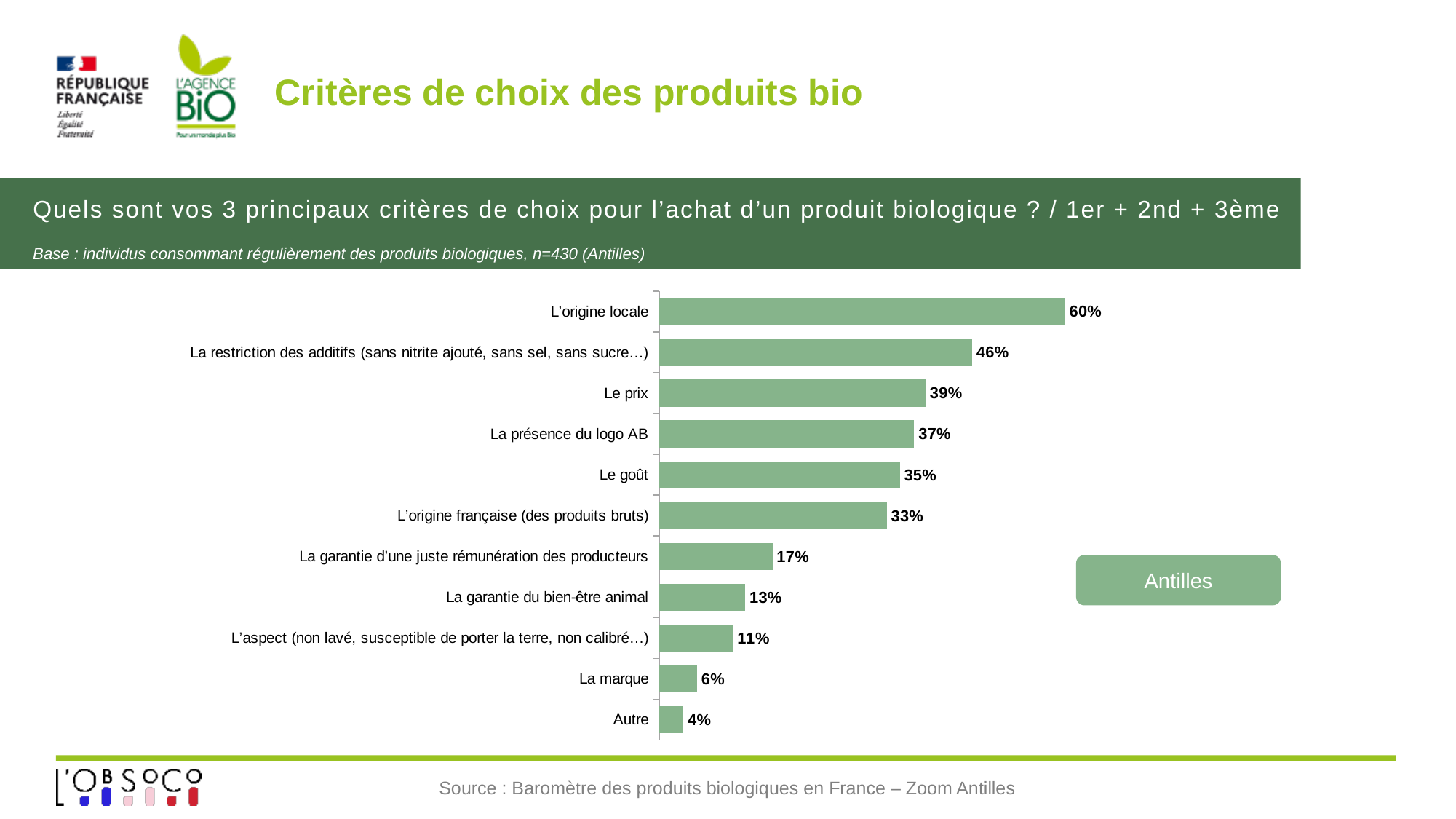
Which category has the highest value? L'origine locale What is the value for "La marque"? 6% What is the value for "La garantie du bien-être animal"? 13% What is the value for "L'origine locale"? 60% How many categories are shown in the chart? 11 What is the difference between "La garantie d'une juste rémunération des producteurs" and "L'aspect (non lavé, susceptible de porter la terre, non calibré…)"? 6% What label appears in the rounded box to the right of the chart? Antilles What is the value for "Le prix"? 39% What kind of chart is shown on the slide? Bar chart What is the difference between "L'origine locale" and "La restriction des additifs (sans nitrite ajouté, sans sel, sans sucre…)"? 14% Which is larger: "Le goût" or "L'origine française (des produits bruts)"? Le goût Which category has the lowest value? Autre